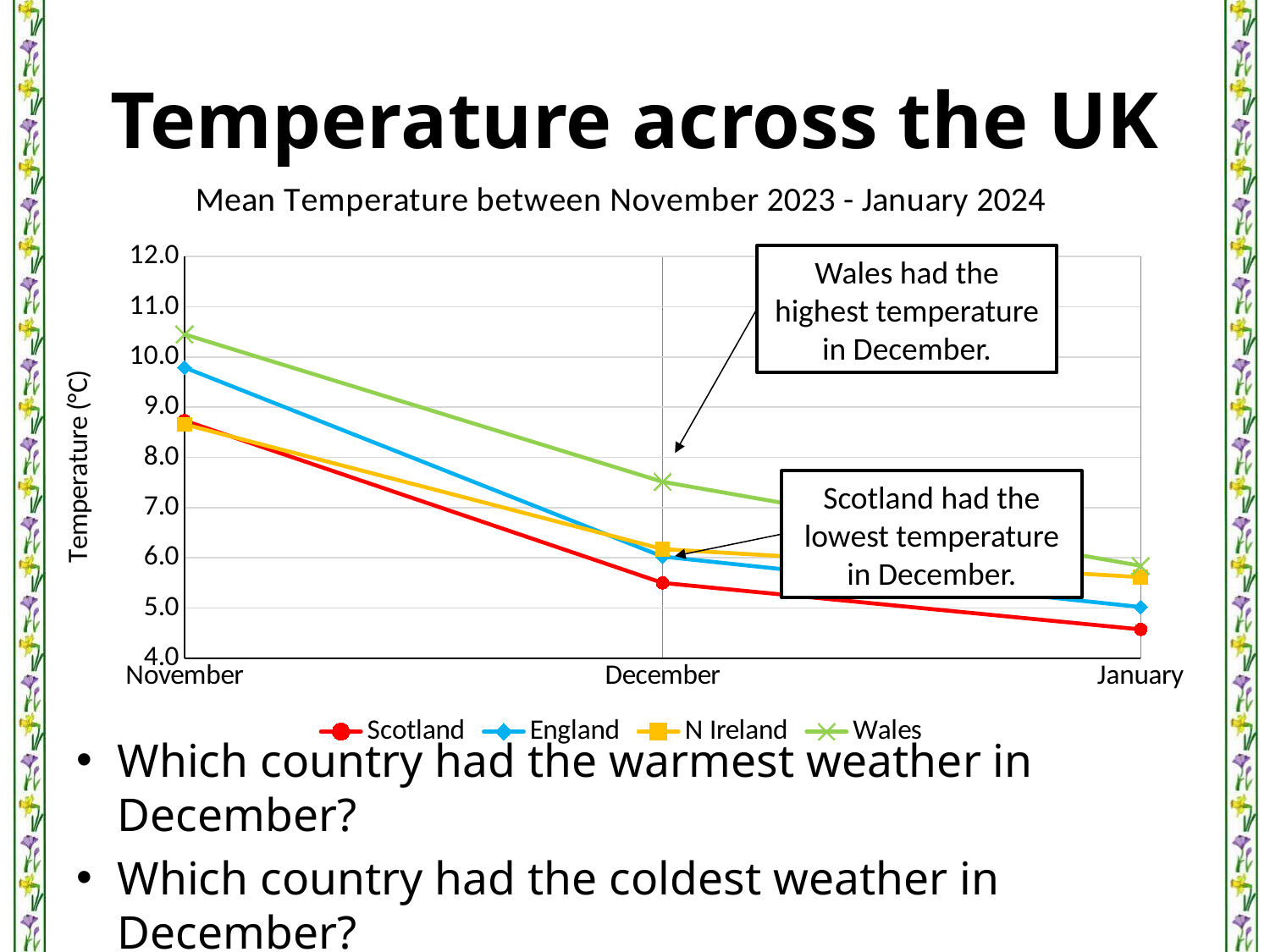
Which country had the highest mean temperature in November? Wales What kind of chart is shown on the slide? Line chart In November, which had the higher mean temperature, England or N Ireland? England Which country had the highest mean temperature in December? Wales Is the value for Wales in November greater or less than 10.0? greater Do the temperatures rise or fall from November to January? Fall How many months are plotted along the x axis? 3 Which country had the lowest mean temperature in December? Scotland How many series does the legend list? 4 Which country had the lowest mean temperature in January? Scotland What is the title of the chart? Mean Temperature between November 2023 - January 2024 Is the value for Scotland in January greater or less than 5.0? less